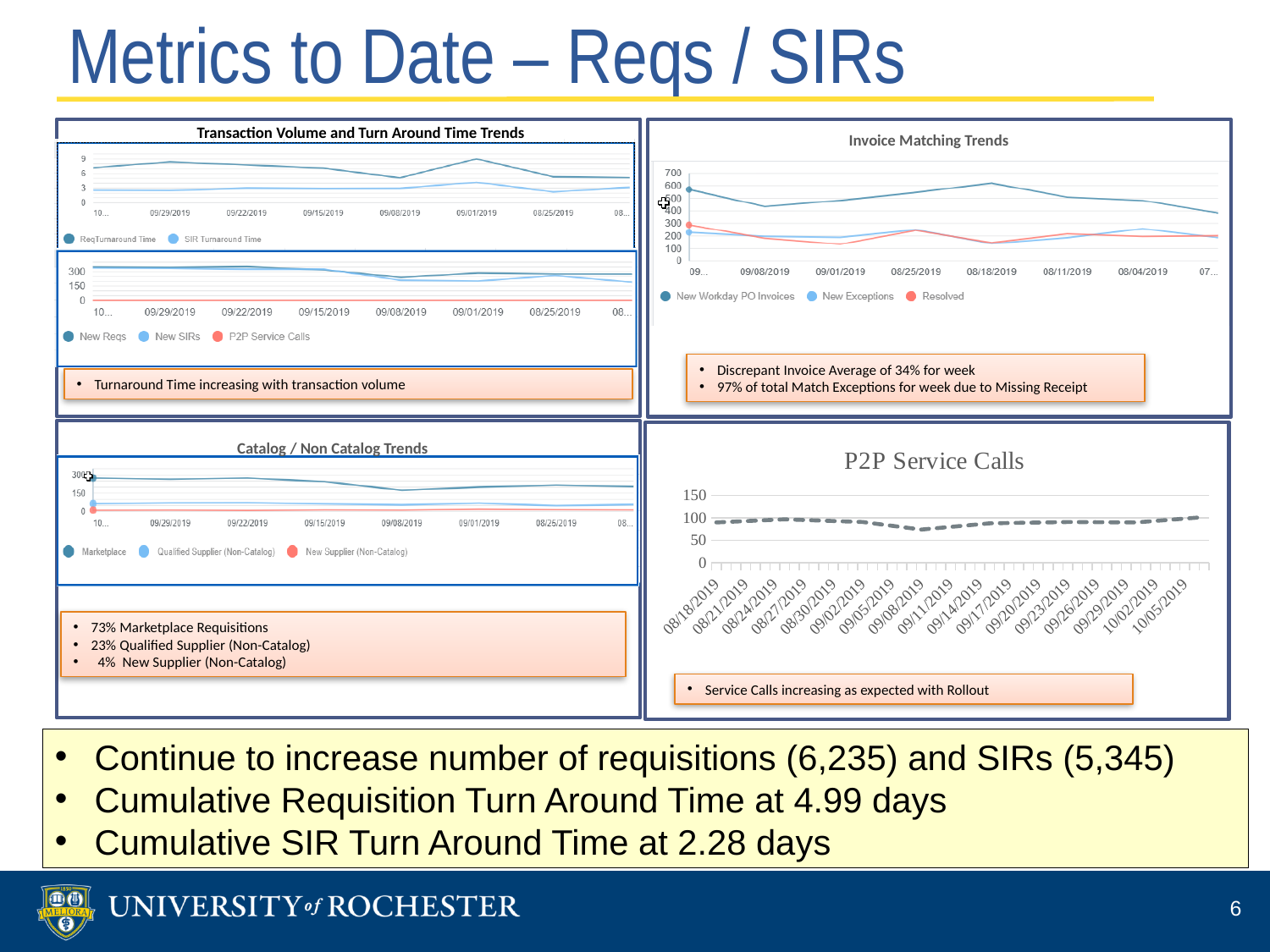
In the Invoice Matching Trends chart, is the value for New Exceptions at 09/01/2019 greater or less than 300? less In the Catalog / Non Catalog Trends chart, is the value for Marketplace at 09/29/2019 greater or less than 150? greater In the Invoice Matching Trends chart, how many series does the legend list? 3 In the P2P Service Calls chart, is the value at 09/08/2019 greater or less than 100? less In the Invoice Matching Trends chart, which is larger at 08/18/2019: New Workday PO Invoices or Resolved? New Workday PO Invoices What is the title of the chart in the top right of the slide? Invoice Matching Trends In the Catalog / Non Catalog Trends chart, which series is higher at 09/22/2019: Marketplace or New Supplier (Non-Catalog)? Marketplace What kind of chart is the P2P Service Calls chart? line chart In the lower chart of the Transaction Volume and Turn Around Time Trends panel, how many series does the legend list? 3 In the Catalog / Non Catalog Trends chart, how many series does the legend list? 3 What are the two legend entries in the upper chart of the Transaction Volume and Turn Around Time Trends panel? ReqTurnaround Time and SIR Turnaround Time